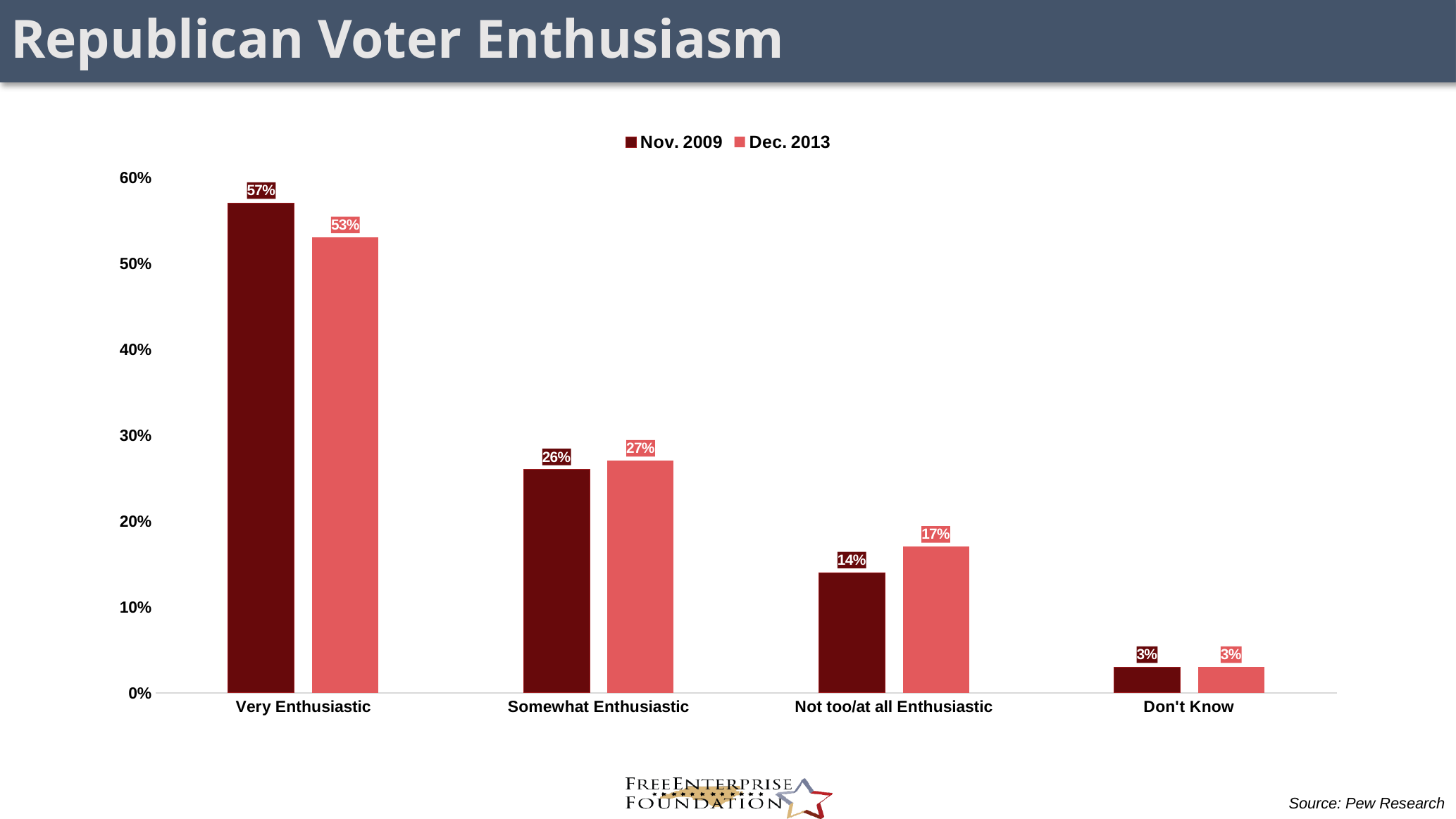
What is the difference between the Dec. 2013 and Nov. 2009 values for Not too/at all Enthusiastic? 3% Which category has the lowest Dec. 2013 value? Don't Know How many categories are shown on the x axis? 4 How many series does the legend list? 2 What kind of chart is shown on the slide? bar chart What is the Dec. 2013 value for Somewhat Enthusiastic? 27% What is the Nov. 2009 value for Very Enthusiastic? 57% Is the Nov. 2009 value for Very Enthusiastic greater or less than 50%? greater What is the difference between the Nov. 2009 and Dec. 2013 values for Very Enthusiastic? 4% Which is larger for Somewhat Enthusiastic: the Nov. 2009 value or the Dec. 2013 value? Dec. 2013 What is the Dec. 2013 value for Not too/at all Enthusiastic? 17% Which category has the highest Nov. 2009 value? Very Enthusiastic